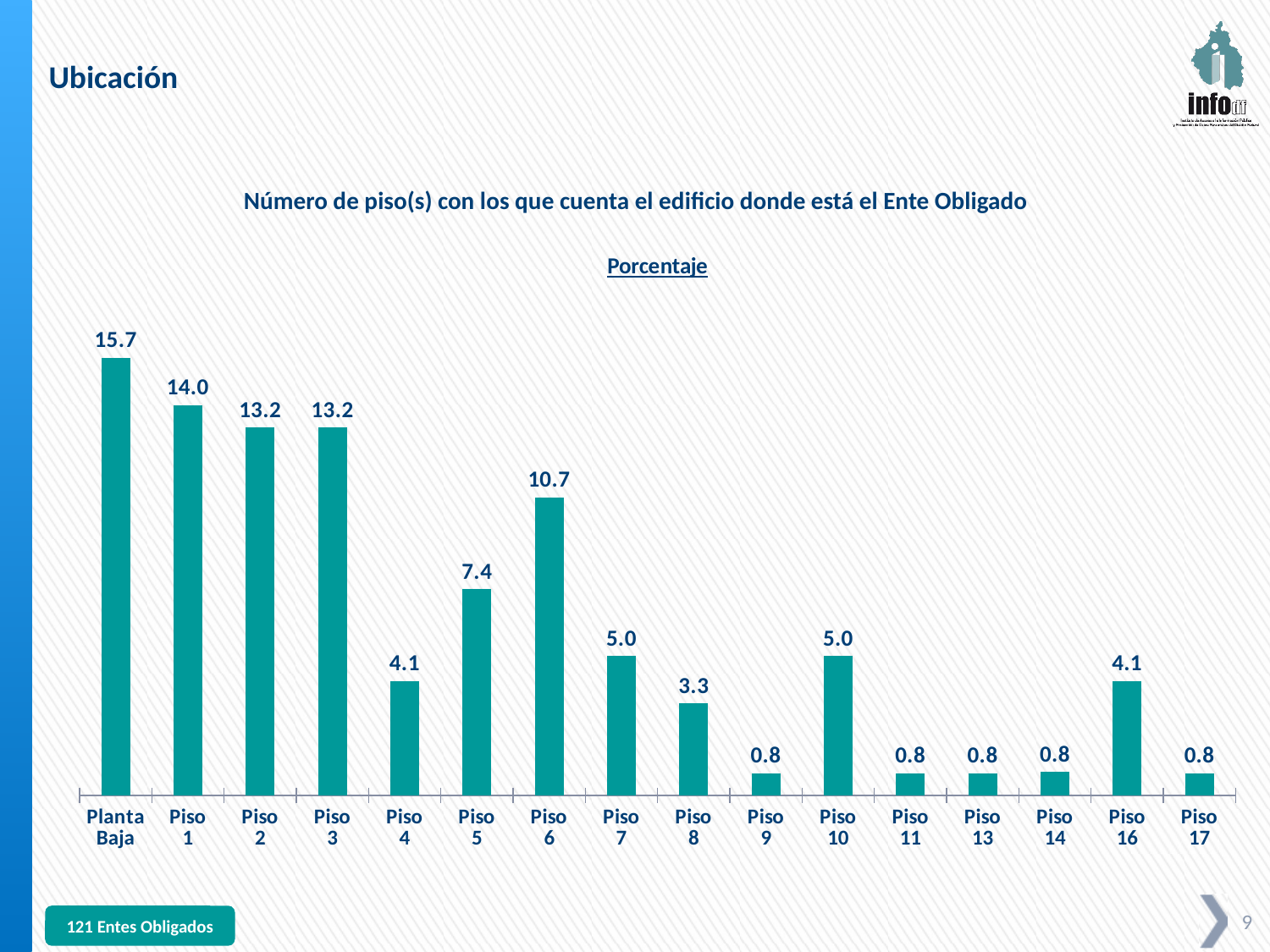
What is the value for Planta Baja? 15.7 What is the difference between the values for Piso 1 and Piso 5? 6.6 Which is larger, the value for Piso 5 or the value for Piso 8? Piso 5 What is the value for Piso 6? 10.7 What is the value for Piso 16? 4.1 What is the title of the chart? Porcentaje How many categories are shown on the x axis? 16 What is the difference between the values for Planta Baja and Piso 10? 10.7 What kind of chart is shown on the slide? Bar chart How many categories have a value of 0.8? 5 Which is larger, the value for Piso 4 or the value for Piso 10? Piso 10 Which category has the highest value? Planta Baja